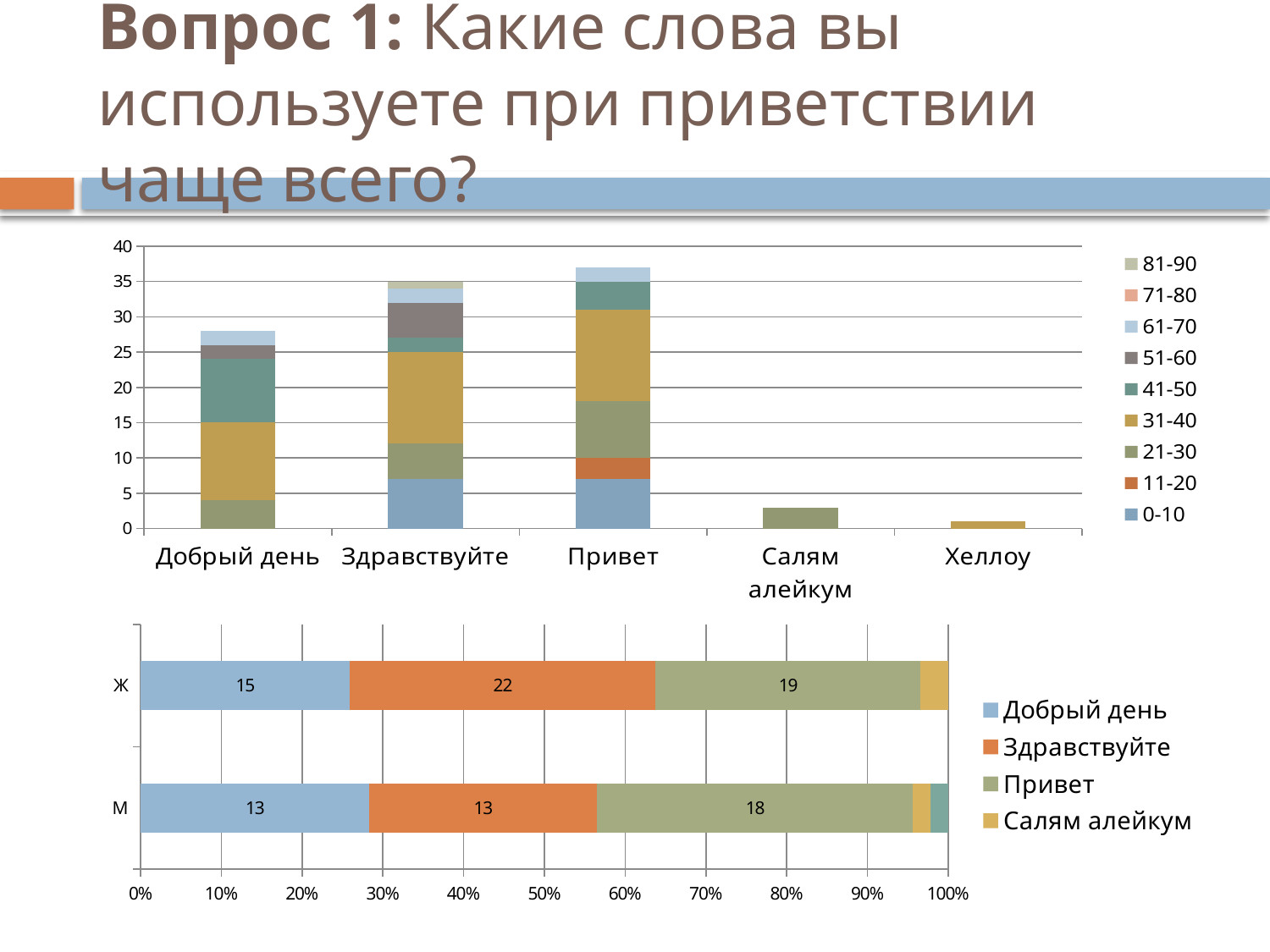
In the bottom chart, what is the value for Привет in the М bar? 18 In the bottom chart, how many bars (categories) are shown? 2 In the bottom chart, which bar has the larger value for Привет, Ж or М? Ж In the top chart, how many categories are shown on the x axis? 5 In the top chart, how many series does the legend list? 9 In the bottom chart, how many series does the legend list? 4 In the bottom chart, what is the difference between the Здравствуйте values for Ж and М? 9 In the top chart, is the total for Добрый день greater or less than 25? greater In the bottom chart, what is the value for Добрый день in the Ж bar? 15 In the top chart, which category has the lowest total? Хеллоу What kind of chart is the top chart? Stacked bar chart In the bottom chart, what is the value for Здравствуйте in the Ж bar? 22